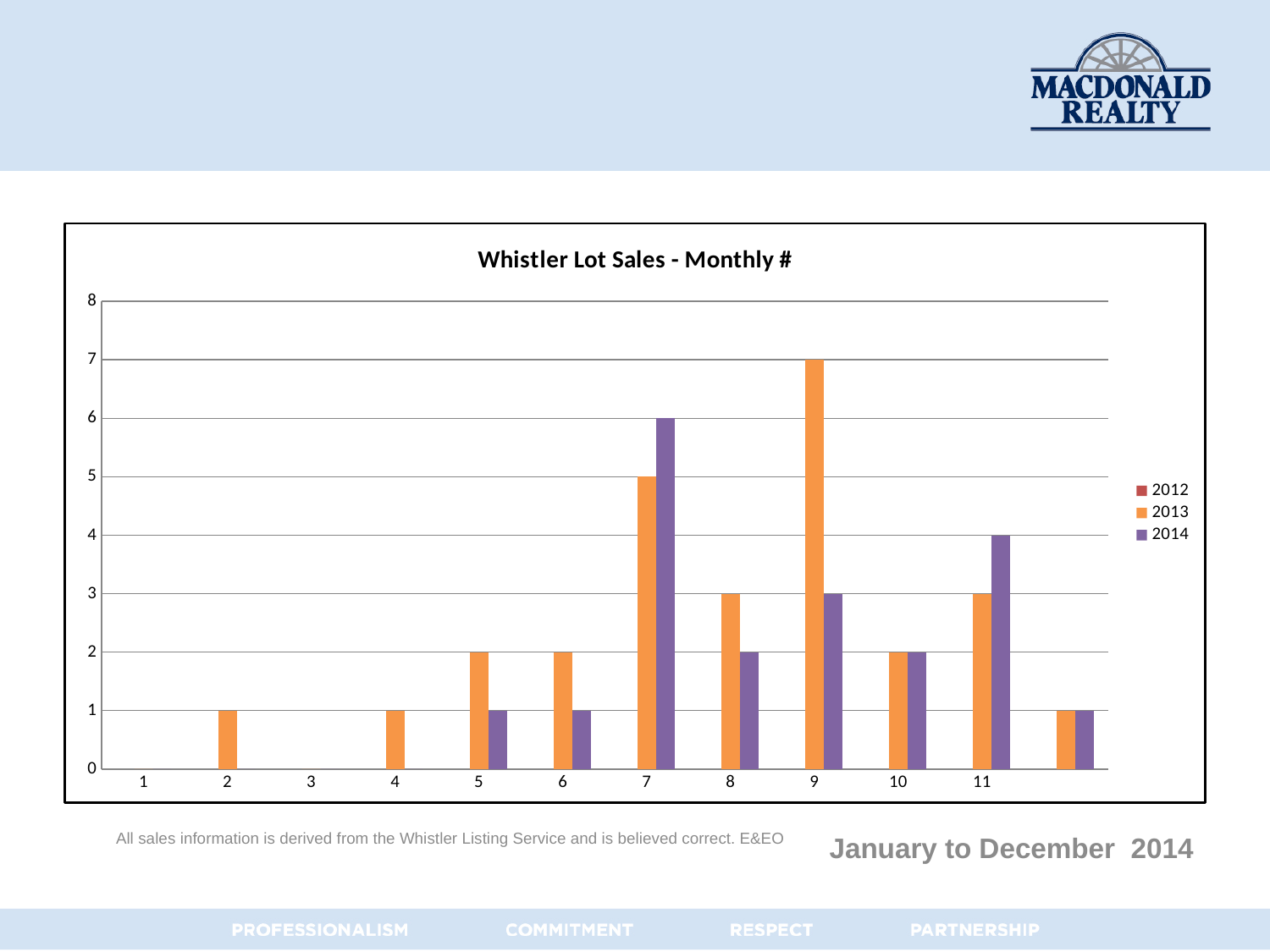
How many series does the legend list? 3 What is the 2013 value for month 2? 1 What type of chart is shown on the slide? bar chart Which month has the highest 2014 value? 7 What is the difference between the 2013 and 2014 values for month 9? 4 Which is larger for month 7, the 2013 value or the 2014 value? 2014 What is the 2014 value for month 7? 6 Is the 2013 value for month 9 greater or less than 6? greater What is the title of the chart? Whistler Lot Sales - Monthly # What is the 2013 value for month 9? 7 What is the 2014 value for month 11? 4 Which month has the highest 2013 value? 9